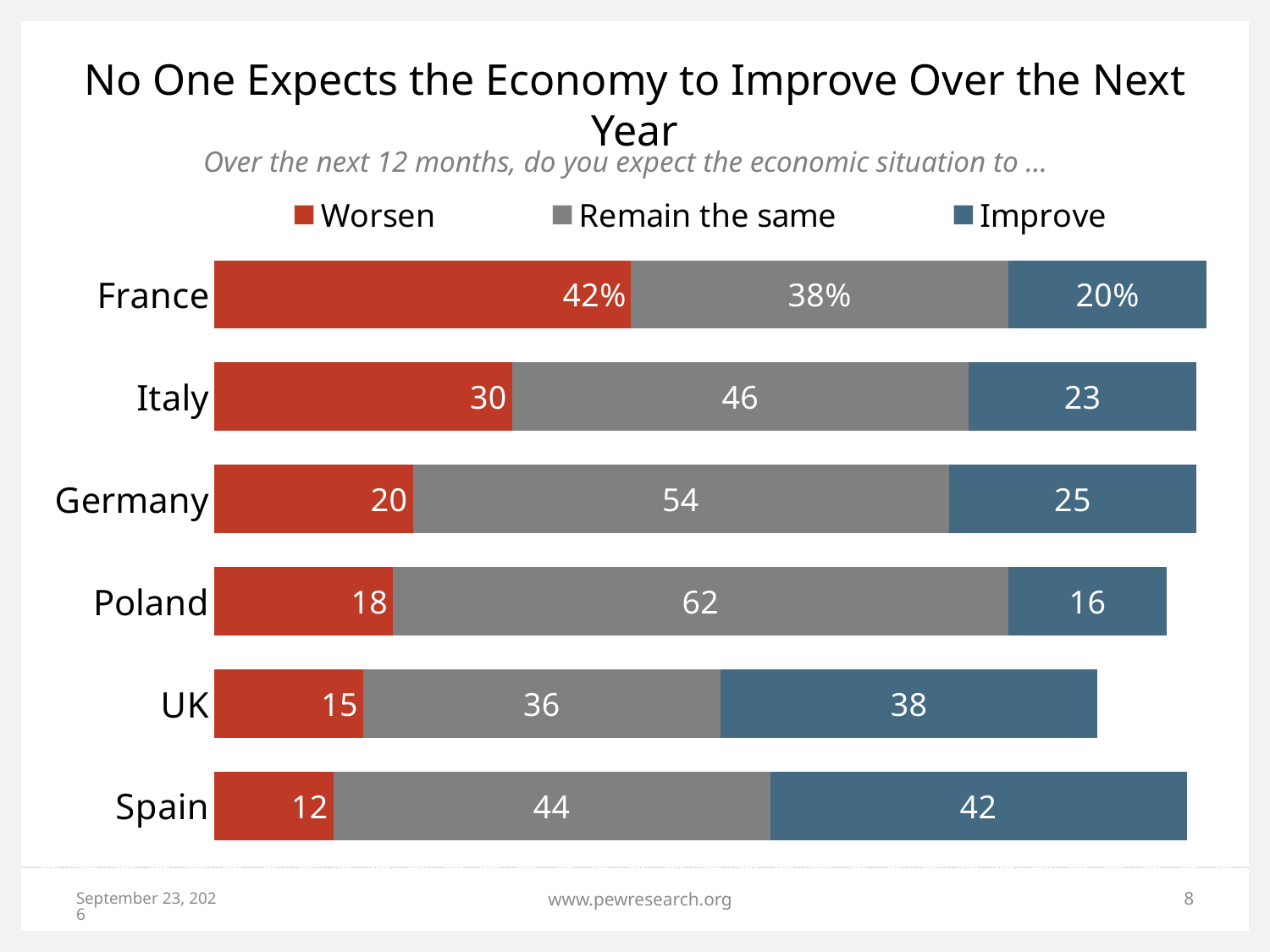
How many countries are shown in the chart? 6 What is the value for 'Remain the same' for Poland? 62 What is the 'Improve' value for Spain? 42 How many series does the legend list? 3 Which country has the highest 'Remain the same' value? Poland Which is larger, the 'Improve' value for the UK or for Germany? UK What is the total of the stacked bar for Italy? 99 What percentage of respondents in France expect the economy to worsen? 42% What is the difference between the 'Improve' values for Spain and Poland? 26 Which country has the lowest 'Worsen' value? Spain What kind of chart is shown on the slide? Stacked bar chart Which country has the highest 'Worsen' value? France